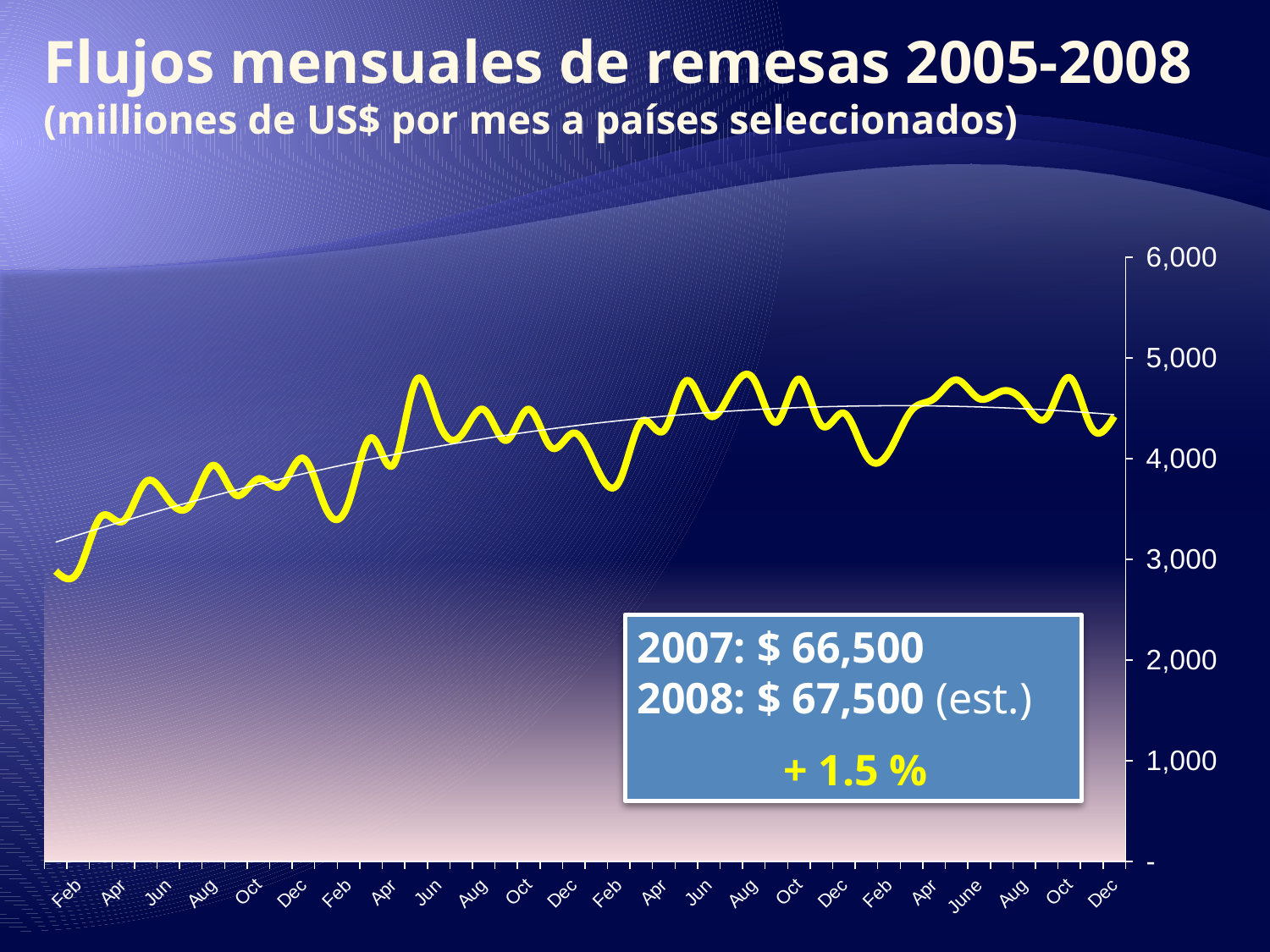
Is the value for the first Feb (2005) greater or less than 3,000? less What kind of chart is shown on the slide? Line chart What is the title of the chart on the slide? Flujos mensuales de remesas 2005-2008 Is the dip value around Feb 2007 greater or less than 4,000? less According to the text box on the chart, what is the estimated remittance total for 2008? $ 67,500 (est.) Is the peak value around Jun 2006 greater or less than 4,000? greater How many month labels are shown on the x axis? 24 Which point on the line has the lowest value? Feb 2005 (the first point) Do the monthly remittance values generally rise or fall from 2005 to 2008? rise What is the highest value shown on the y axis? 6,000 Which is larger, the value for the first Feb (2005) or the value for the last Dec (2008)? Dec 2008